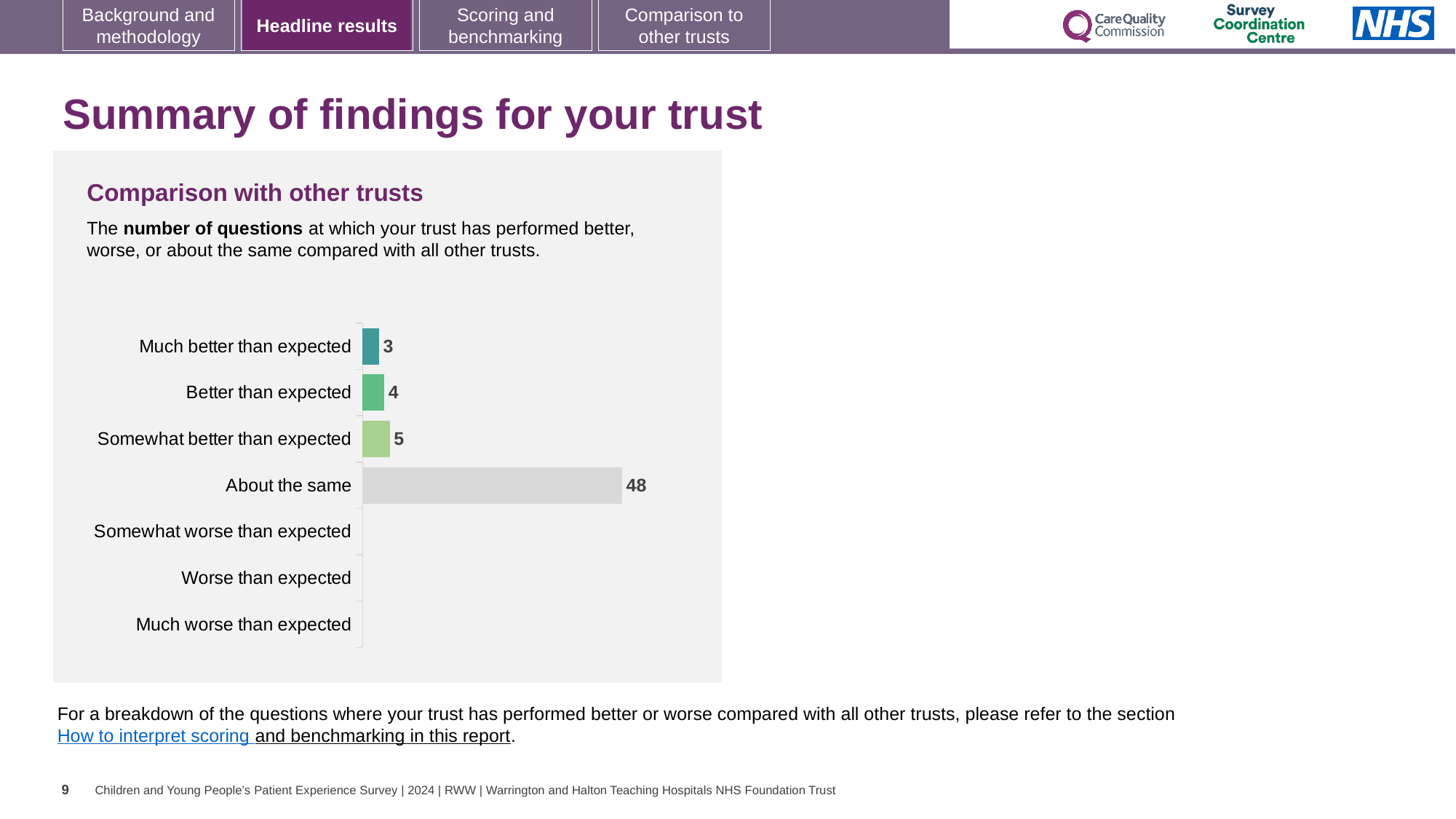
What is the value for 'Better than expected'? 4 How many categories are listed on the chart's axis? 7 What colour is the bar for 'About the same'? Grey What kind of chart is shown on the slide? Bar chart Which category has the highest value? About the same What is the value for 'Somewhat better than expected'? 5 What is the difference between the values for 'About the same' and 'Somewhat better than expected'? 43 What is the difference between the values for 'Somewhat better than expected' and 'Much better than expected'? 2 What is the value for 'About the same'? 48 What is the value for 'Much better than expected'? 3 What is the title of the chart? Comparison with other trusts Which is larger, the value for 'Better than expected' or the value for 'Much better than expected'? Better than expected